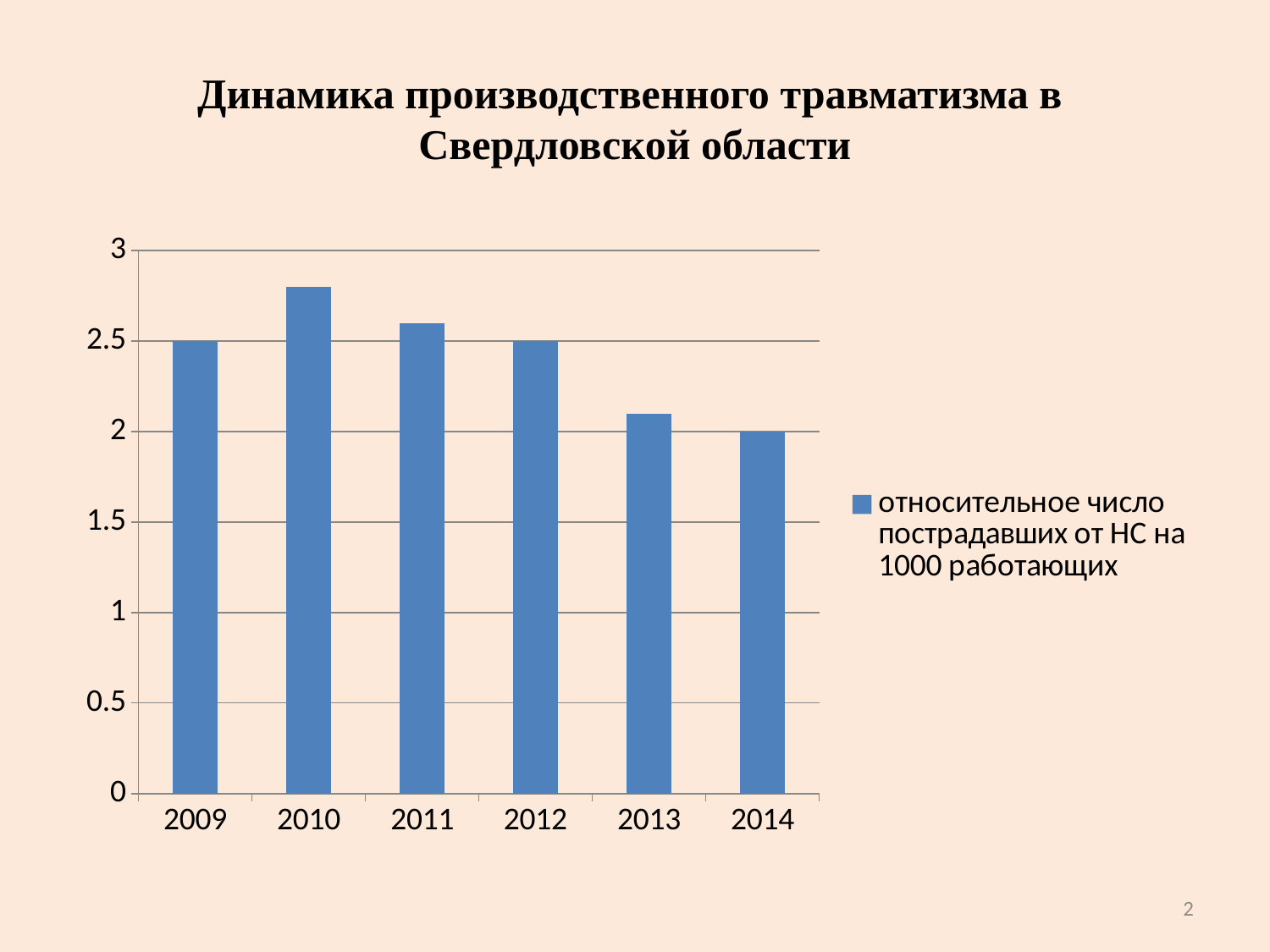
Is the value for 2010 greater or less than 2.5? greater How many years are shown on the x axis of the chart? 6 Do the values generally rise or fall from 2010 to 2014? fall What is the value for 2014? 2 What type of chart is shown on the slide? bar chart What is the value for 2009? 2.5 What is the legend entry for the series in the chart? относительное число пострадавших от НС на 1000 работающих How many series does the legend list? 1 Which year has the lowest value in the chart? 2014 Is the value for 2013 greater or less than 2.5? less Which is larger, the value for 2011 or the value for 2013? 2011 Which year has the highest value in the chart? 2010